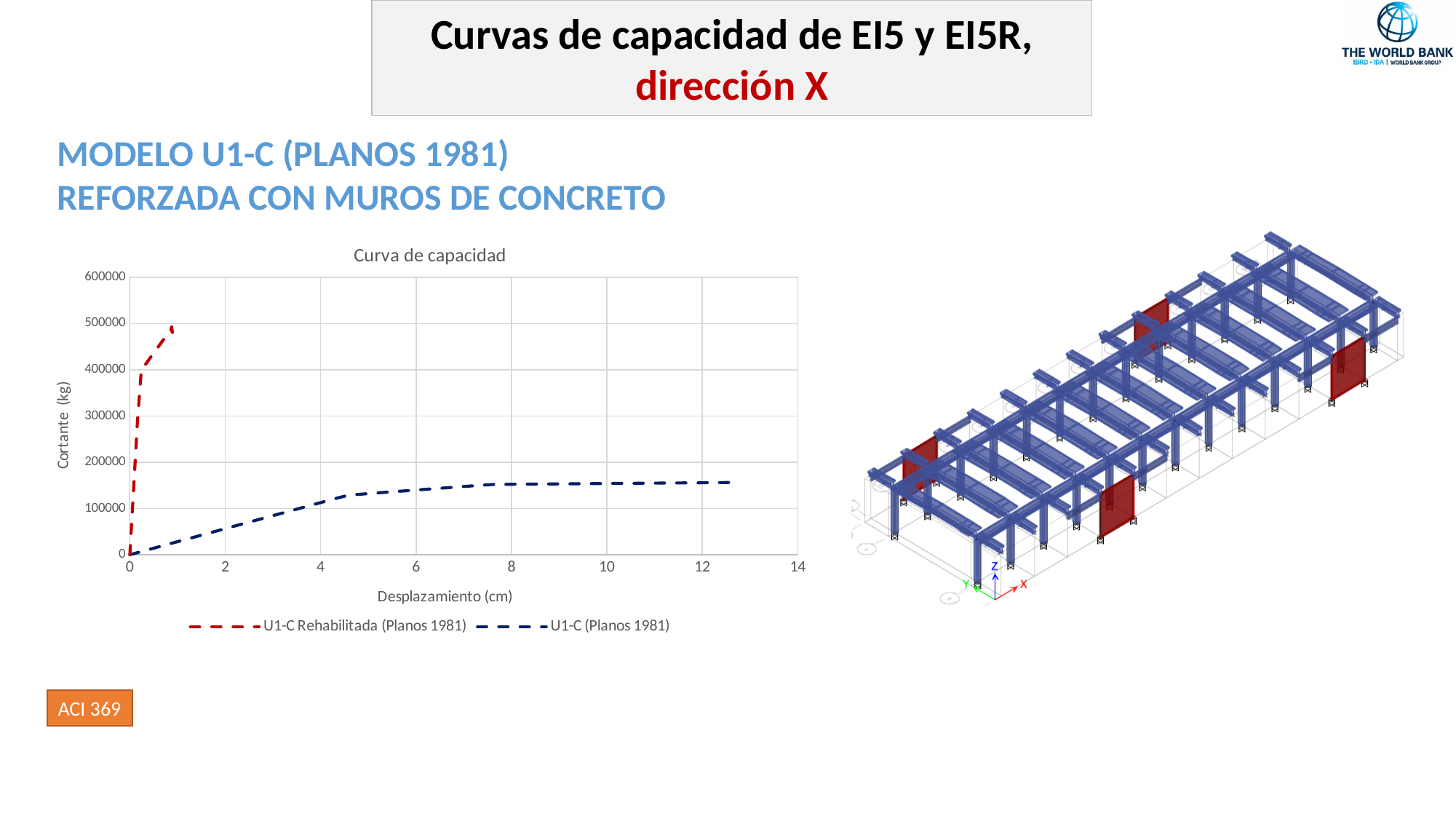
Which series extends to the larger Desplazamiento (cm) value? U1-C (Planos 1981) Which series reaches the higher maximum Cortante (kg) value? U1-C Rehabilitada (Planos 1981) Is the Cortante value of the U1-C (Planos 1981) series at a Desplazamiento of 12 cm greater or less than 100000? greater Is the Desplazamiento at which the U1-C Rehabilitada (Planos 1981) series ends greater or less than 2 cm? less Do the Cortante values of the U1-C (Planos 1981) series rise or fall as Desplazamiento increases? rise What kind of chart is shown on the slide? Line chart How many series does the legend of the chart list? 2 Is the Desplazamiento at which the U1-C (Planos 1981) series ends greater or less than 12 cm? greater What is the title of the chart? Curva de capacidad What is the label of the x axis of the chart? Desplazamiento (cm)